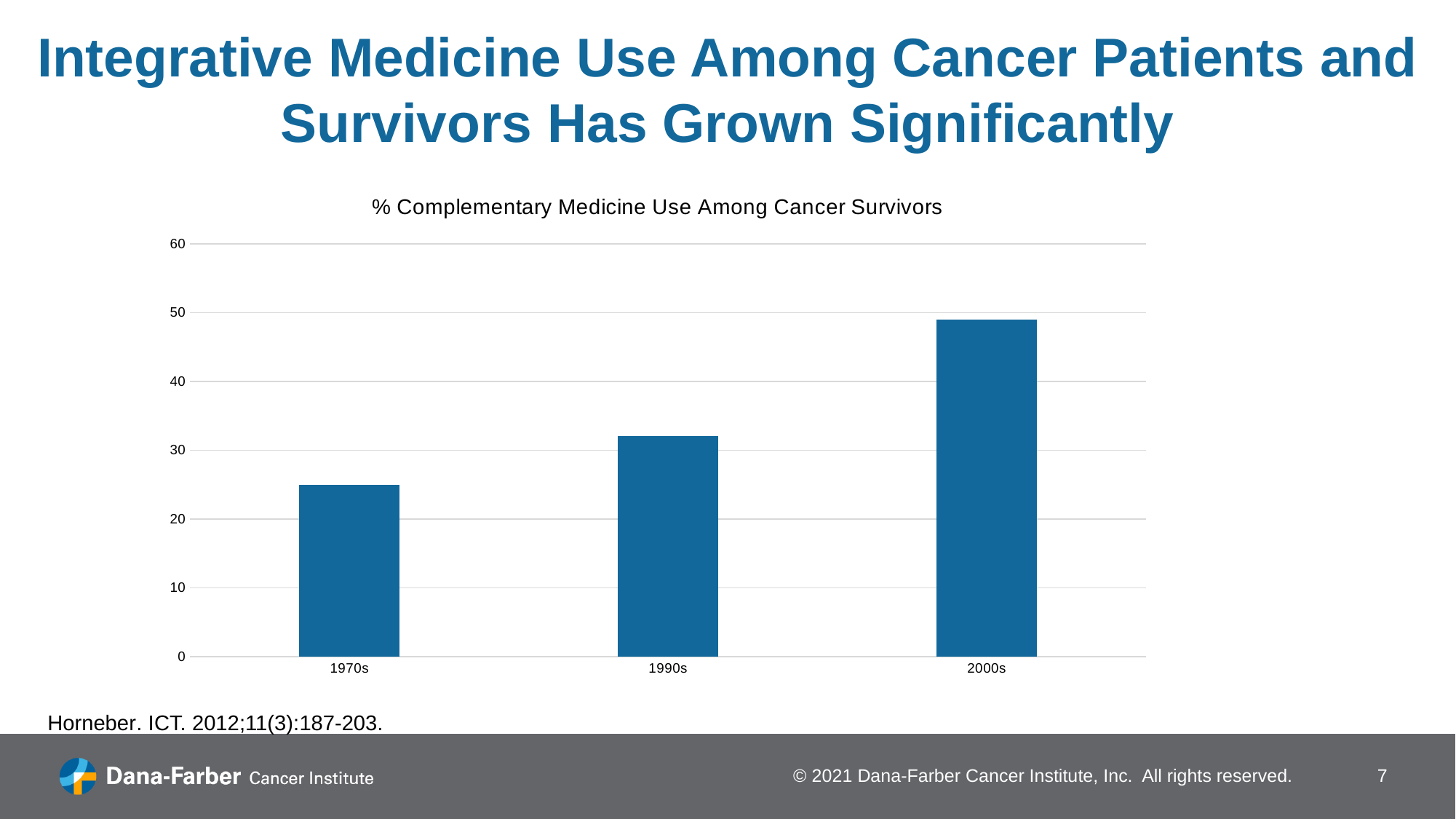
How many categories are shown on the x axis of the chart? 3 What kind of chart is shown on the slide? bar chart Which decade has the highest value in the chart? 2000s Do the values rise or fall from the 1970s to the 2000s? rise Is the value for the 1990s greater or less than 40? less What is the highest value shown on the y axis of the chart? 60 Is the value for the 2000s greater or less than 40? greater Is the value for the 1970s greater or less than 20? greater Which decade has the lowest value in the chart? 1970s Which is larger, the value for the 1990s or the value for the 2000s? 2000s What is the title of the chart? % Complementary Medicine Use Among Cancer Survivors